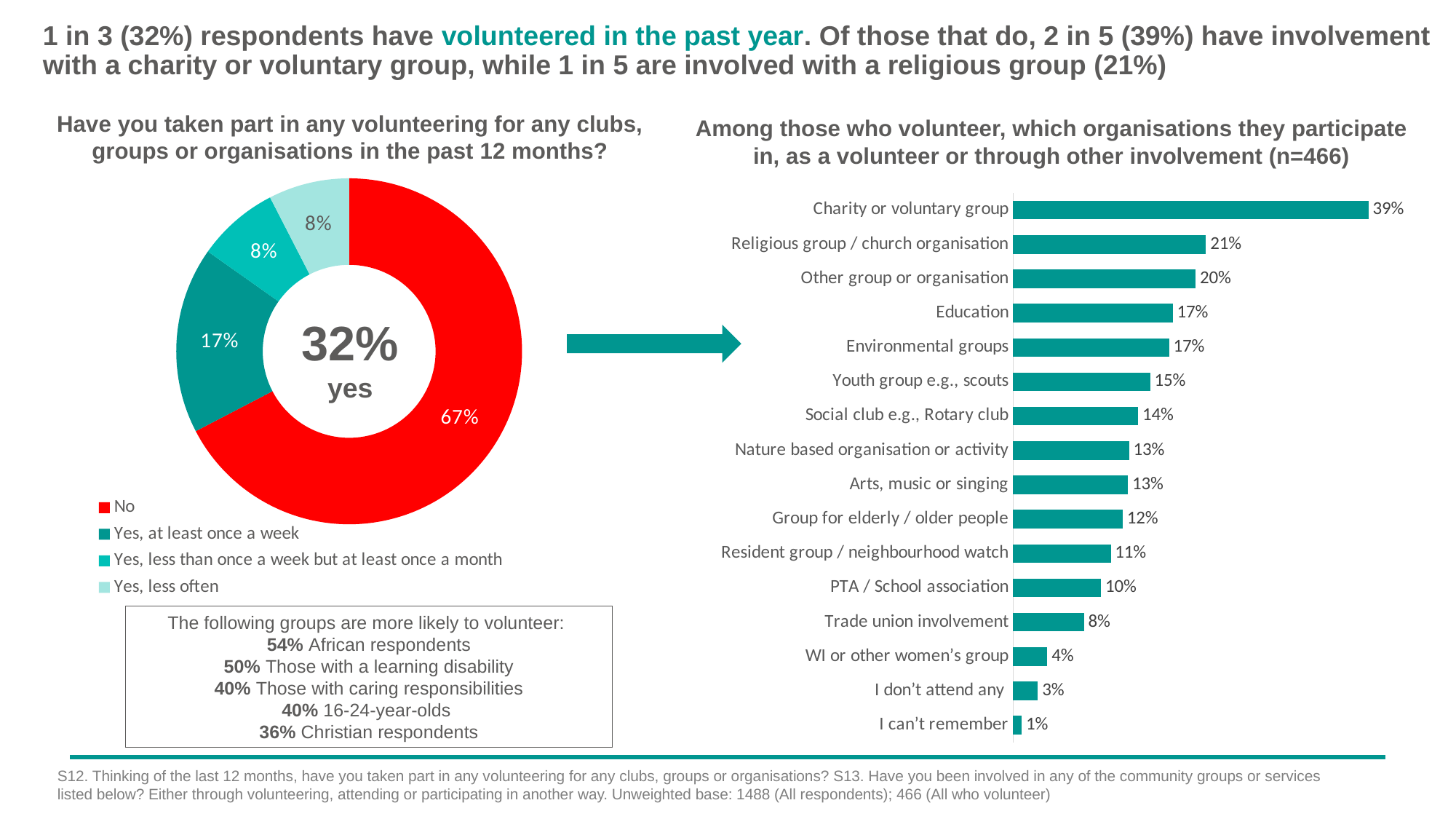
What type of chart is shown on the right of the slide? Bar chart In the bar chart on the right, which category has the lowest value? I can't remember In the doughnut chart on the left, what percentage answered 'Yes, at least once a week'? 17% How many categories are shown in the bar chart on the right? 16 In the doughnut chart on the left, what percentage of respondents answered 'No'? 67% In the bar chart on the right, what is the value for 'Trade union involvement'? 8% What type of chart is shown on the left of the slide? Doughnut chart In the bar chart on the right, what is the value for 'Education'? 17% In the bar chart on the right, which is larger: 'Youth group e.g., scouts' or 'PTA / School association'? Youth group e.g., scouts In the doughnut chart on the left, how many categories does the legend list? 4 In the bar chart on the right, which organisation has the highest value? Charity or voluntary group In the bar chart on the right, what is the difference between 'Charity or voluntary group' and 'Religious group / church organisation'? 18%